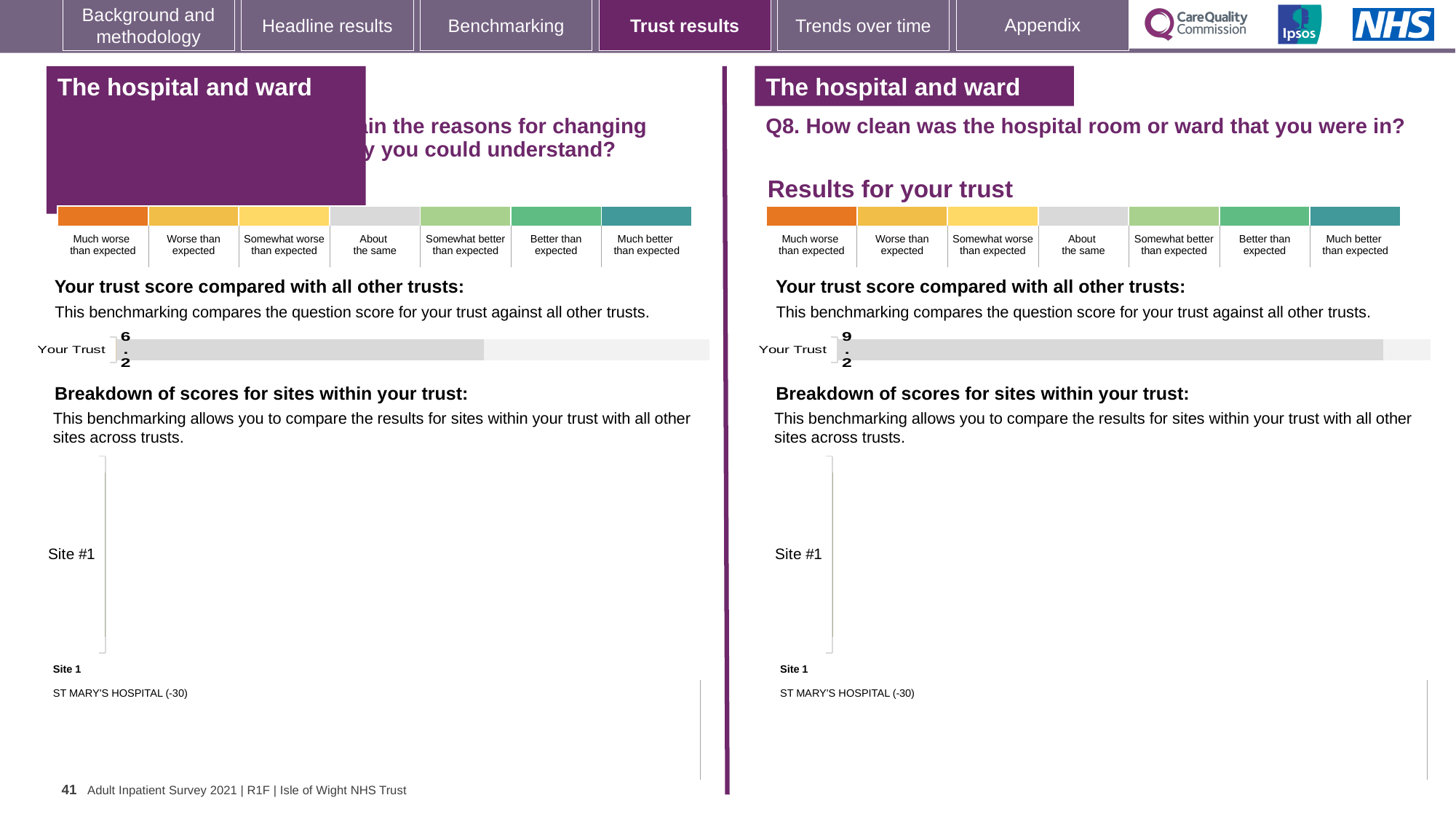
Which is larger: the Your Trust score on the left chart or the Your Trust score on the right chart (Q8)? The right chart (Q8) How many categories are plotted in the 'Your trust score compared with all other trusts' chart on the left? 1 What kind of chart is used to show the Your Trust score on the right chart (Q8)? Bar chart How many rating bands are shown in the colour scale above the right chart (Q8)? 7 What is the difference between the Your Trust score on the right chart (Q8) and the Your Trust score on the left chart? 3.0 On the left chart, what is the score shown for Your Trust? 6.2 What is the label of the single category plotted in the 'Your trust score compared with all other trusts' chart on the right (Q8)? Your Trust On the right chart (Q8. How clean was the hospital room or ward that you were in?), what is the score shown for Your Trust? 9.2